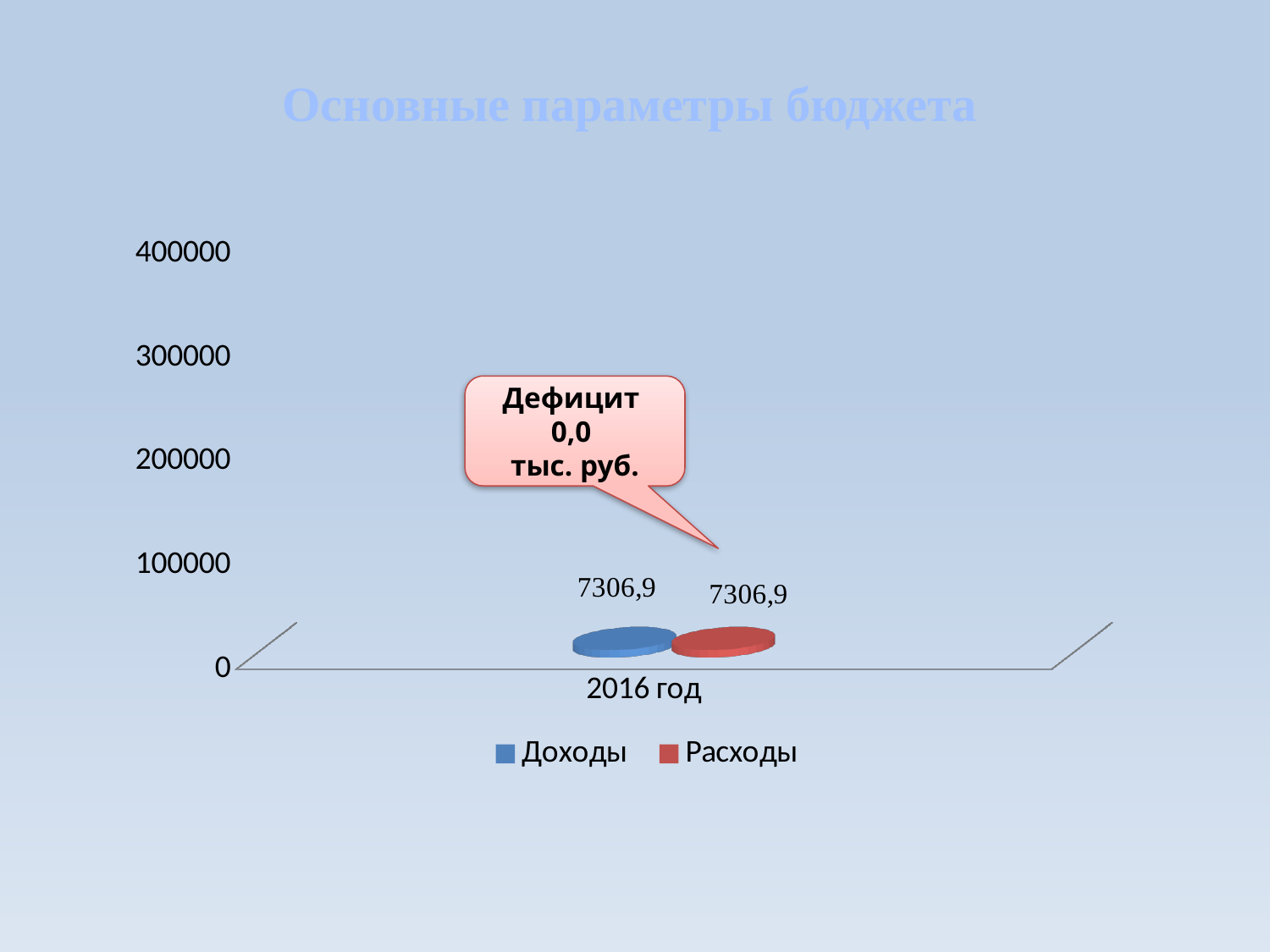
What is the highest value shown on the vertical axis? 400000 Which series is shown in blue? Доходы How many series does the legend list? 2 What deficit amount does the callout on the chart state? 0,0 тыс. руб. How many categories are shown on the x axis? 1 Is the value for Доходы in 2016 год greater or less than 100000? less What is the title of the chart? Основные параметры бюджета Is the value for Расходы in 2016 год greater or less than 100000? less What is the value for Доходы in 2016 год? 7306,9 What kind of chart is shown on the slide? bar chart What is the value for Расходы in 2016 год? 7306,9 What is the difference between Расходы and Доходы in 2016 год? 0